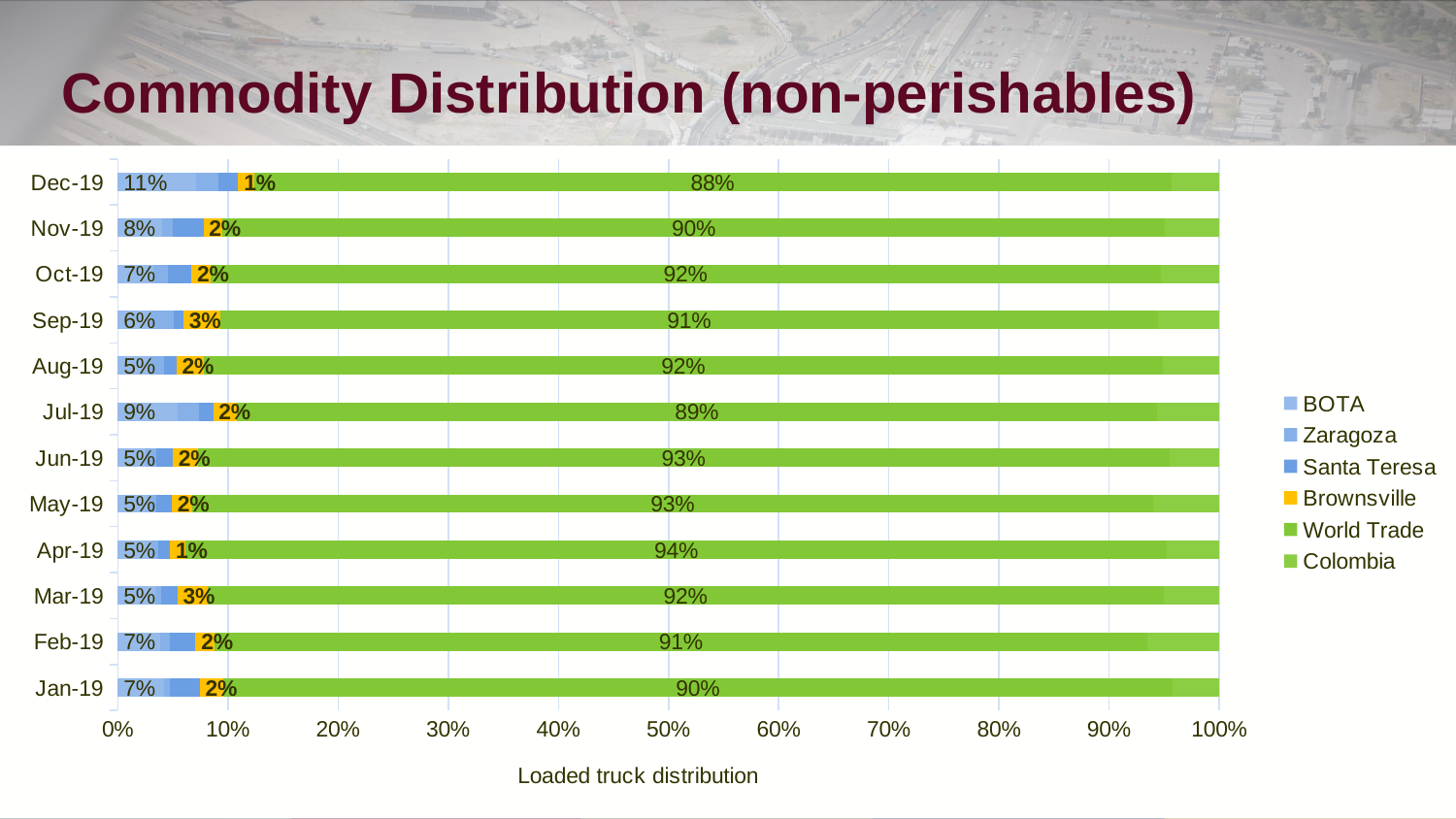
How many series does the legend list? 6 What is the Brownsville share for Sep-19? 3% What is the difference between the World Trade share in Apr-19 and in Dec-19? 6 percentage points Which month has the lowest World Trade share? Dec-19 Which month has a larger BOTA share, Jul-19 or Nov-19? Jul-19 What is the title of the horizontal axis? Loaded truck distribution What kind of chart is shown on the slide? Stacked bar chart Which month has the highest World Trade share? Apr-19 How many months are shown on the chart? 12 Which month has the highest BOTA share? Dec-19